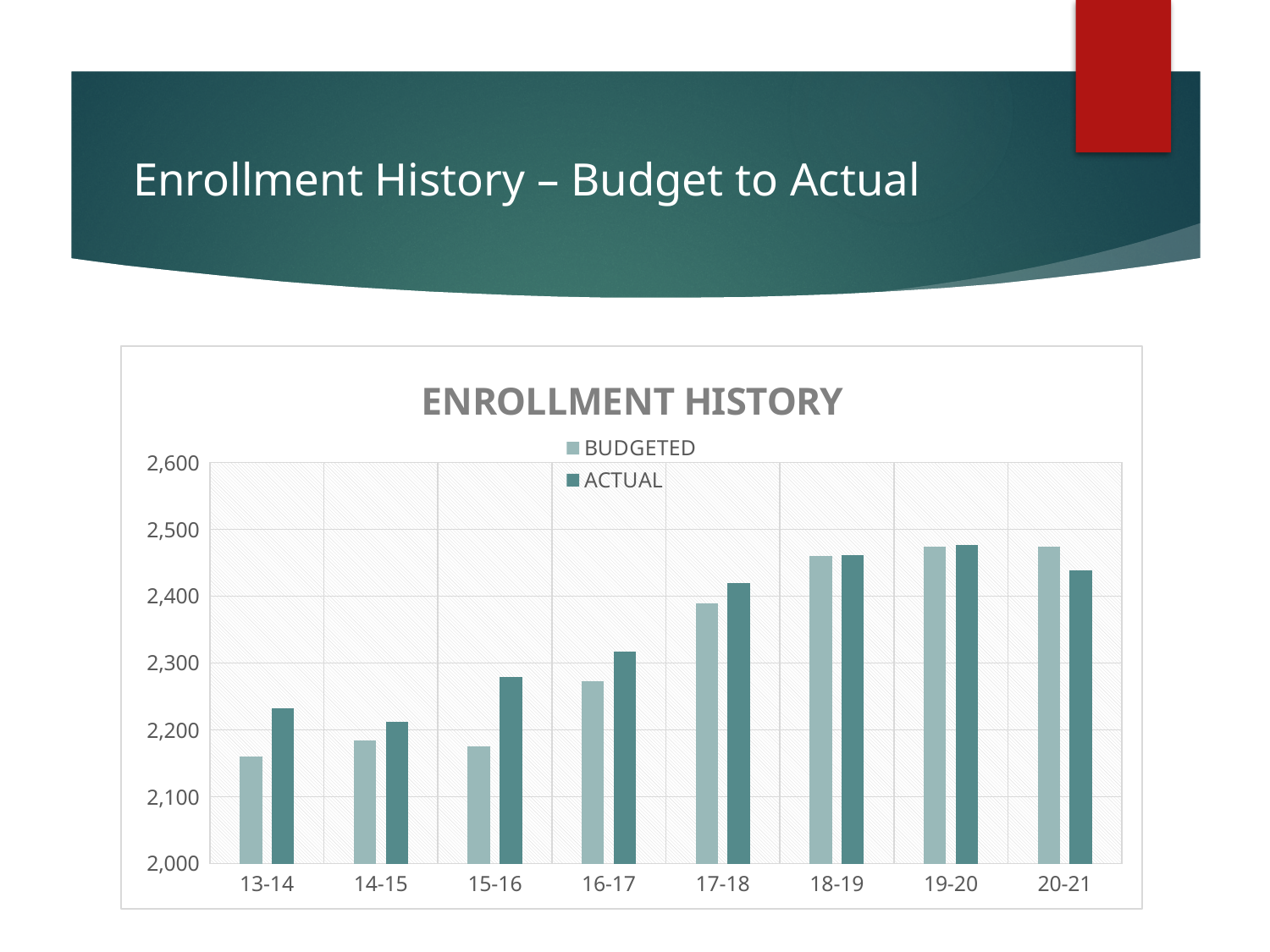
Is the ACTUAL value for 15-16 greater or less than 2,300? less Is the ACTUAL value for 17-18 greater or less than 2,400? greater What are the two series named in the legend of the Enrollment History chart? BUDGETED and ACTUAL How many school years are shown on the x axis of the Enrollment History chart? 8 For 15-16, which is larger, the BUDGETED value or the ACTUAL value? ACTUAL How many series does the legend of the Enrollment History chart list? 2 What type of chart is shown on the slide? Bar chart For 20-21, which is larger, the BUDGETED value or the ACTUAL value? BUDGETED Is the BUDGETED value for 13-14 greater or less than 2,200? less What is the title of the chart on the slide? ENROLLMENT HISTORY